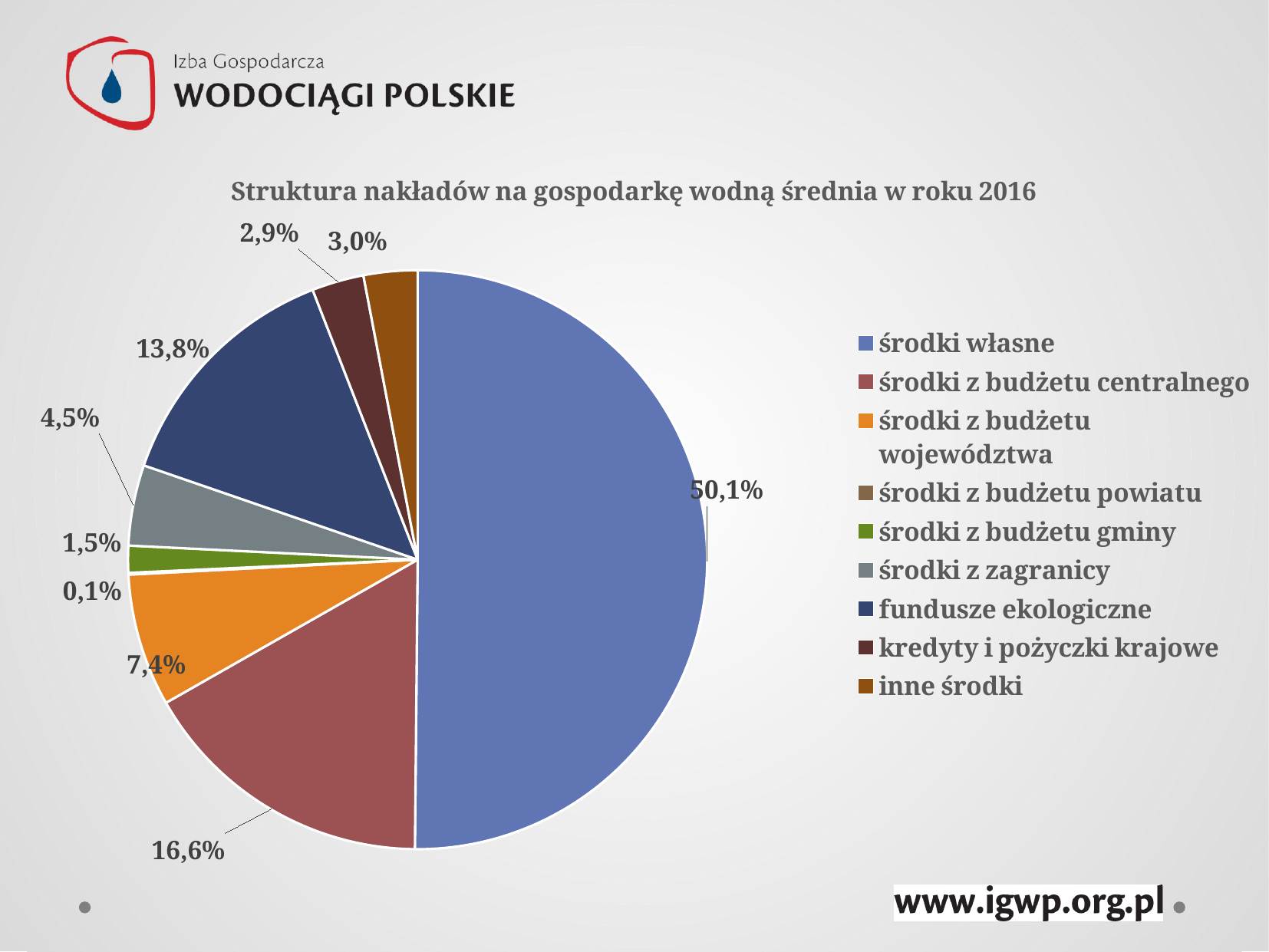
What kind of chart is shown on the slide? pie chart What is the value shown for 'środki z zagranicy'? 4,5% What is the title of the chart? Struktura nakładów na gospodarkę wodną średnia w roku 2016 Which category has the largest share of the pie? środki własne What is the value shown for 'fundusze ekologiczne'? 13,8% How many categories does the legend of the pie chart list? 9 Which category has the smallest share of the pie? środki z budżetu powiatu What is the value shown for 'środki z budżetu centralnego'? 16,6% Which is larger, the share of 'fundusze ekologiczne' or the share of 'środki z budżetu województwa'? fundusze ekologiczne What is the value shown for 'inne środki'? 3,0% What is the difference between the shares of 'środki z budżetu centralnego' and 'środki z budżetu województwa'? 9,2% What share of the pie is 'środki własne'? 50,1%